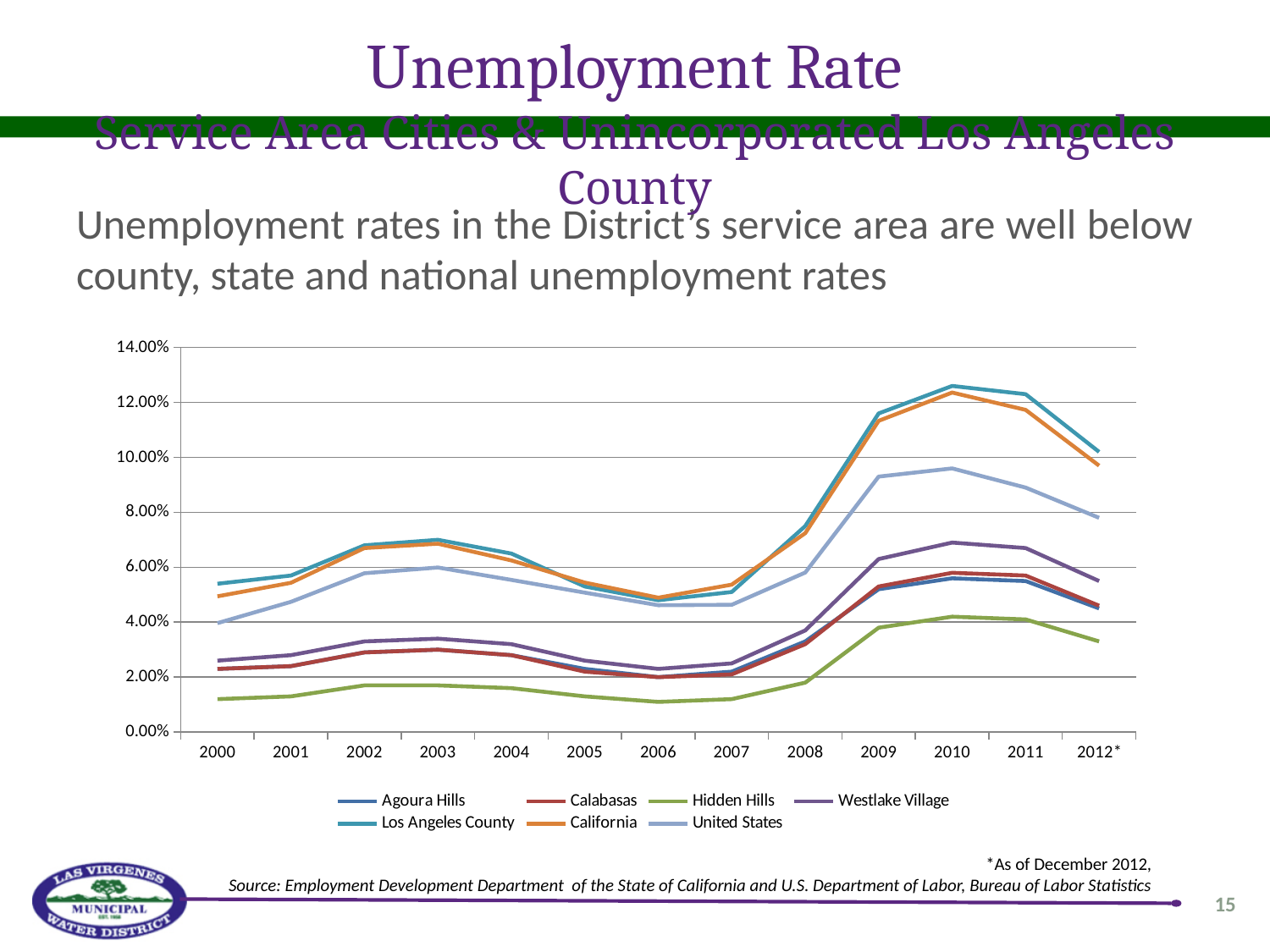
Is the value for Los Angeles County in 2010 greater or less than 12.00%? greater How many series does the legend list? 7 In 2010, which is larger: the value for Westlake Village or the value for Calabasas? Westlake Village How many years are plotted along the x axis? 13 Does the Los Angeles County line rise or fall from 2010 to 2012*? Fall Is the value for Hidden Hills in 2006 greater or less than 2.00%? less Is the value for Westlake Village in 2012* greater or less than 6.00%? less Which series has the lowest value in 2010? Hidden Hills What kind of chart is shown on the slide? Line chart In which year is the United States value lowest? 2000 In which year does Los Angeles County reach its highest value? 2010